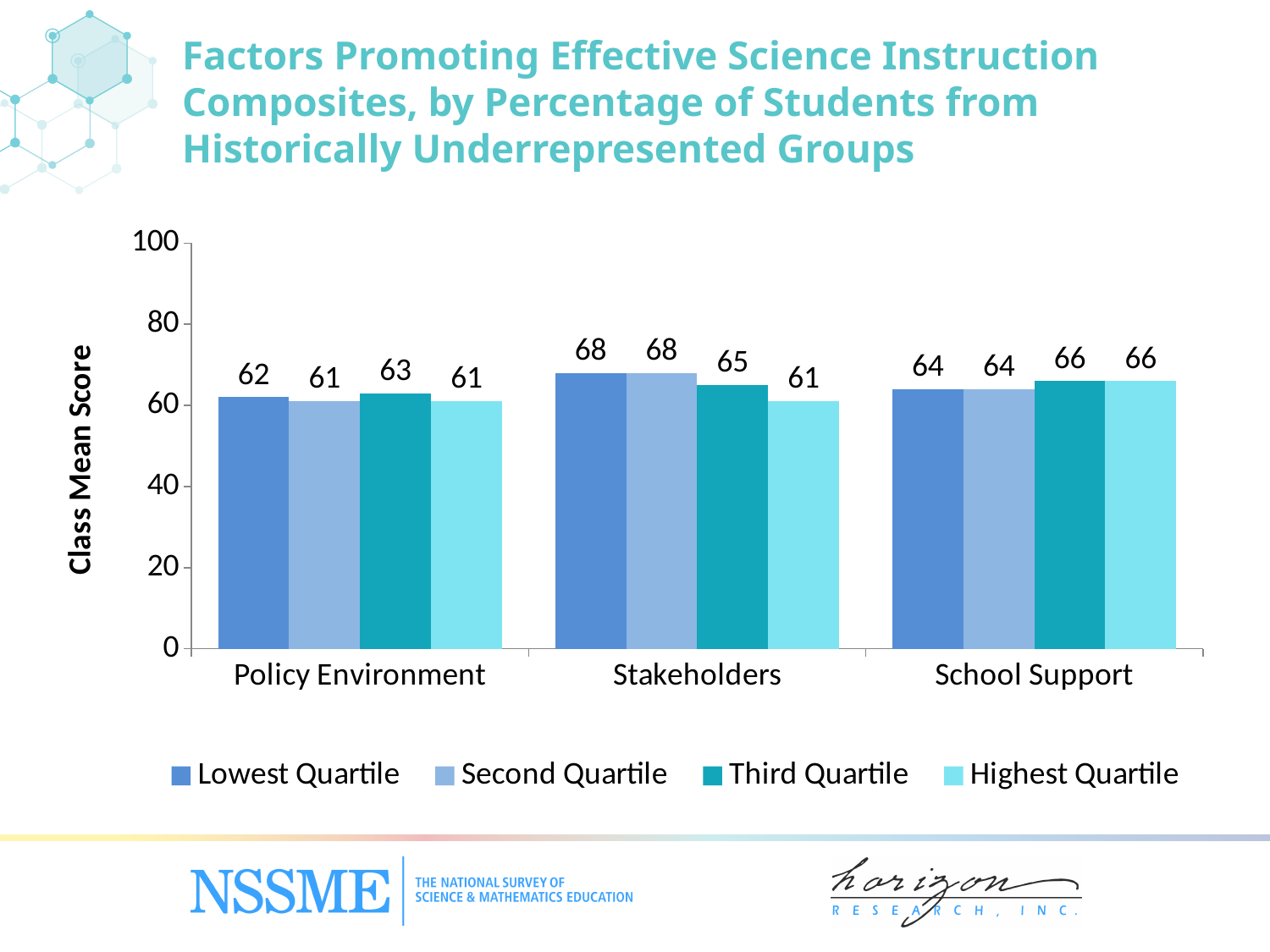
What is the class mean score for the Second Quartile on the Stakeholders composite? 68 What is the class mean score for the Third Quartile on the School Support composite? 66 Which composite has the highest class mean score for the Lowest Quartile? Stakeholders What kind of chart is shown on the slide? Bar chart What is the class mean score for the Lowest Quartile on the Policy Environment composite? 62 How many series does the legend list? 4 What is the difference between the Lowest Quartile and Highest Quartile class mean scores on the Stakeholders composite? 7 How many composites are shown on the x axis? 3 Is the Lowest Quartile score on Stakeholders greater or less than 80? less What is the class mean score for the Highest Quartile on the Stakeholders composite? 61 Which quartile has the lowest class mean score on the Stakeholders composite? Highest Quartile Which is larger: the Third Quartile score on Policy Environment or the Third Quartile score on School Support? School Support